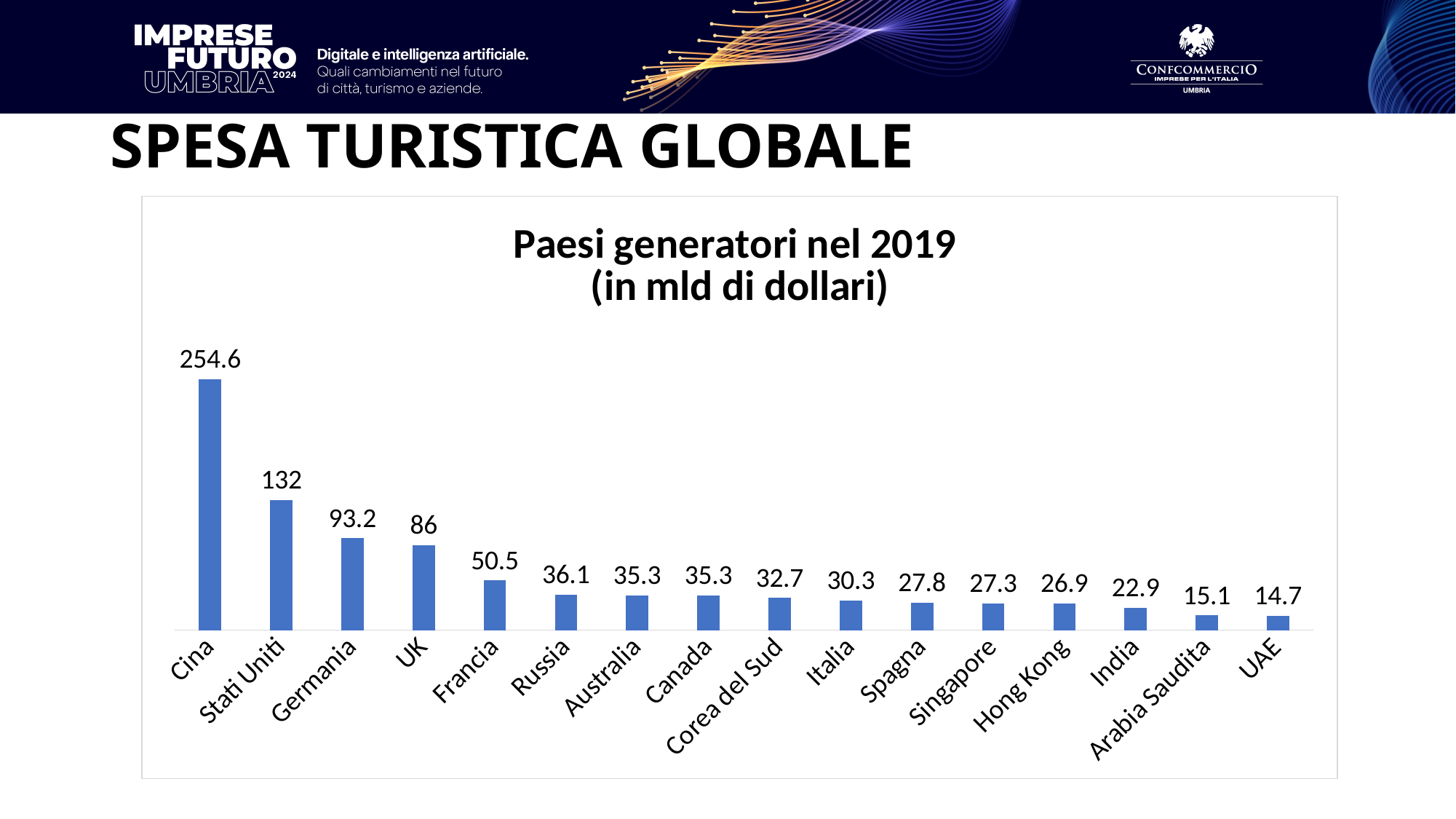
What is the value for Stati Uniti? 132 What kind of chart is shown? Bar chart Which country has the lowest value? UAE What is the difference between the values for Cina and Stati Uniti? 122.6 What is the value for Italia? 30.3 Which has a larger value, Francia or Russia? Francia What is the difference between the values for Germania and UK? 7.2 Which country has the highest value? Cina How many countries are shown in the chart? 16 What is the value for Corea del Sud? 32.7 What is the title of the chart? Paesi generatori nel 2019 (in mld di dollari) Which has a larger value, India or Arabia Saudita? India